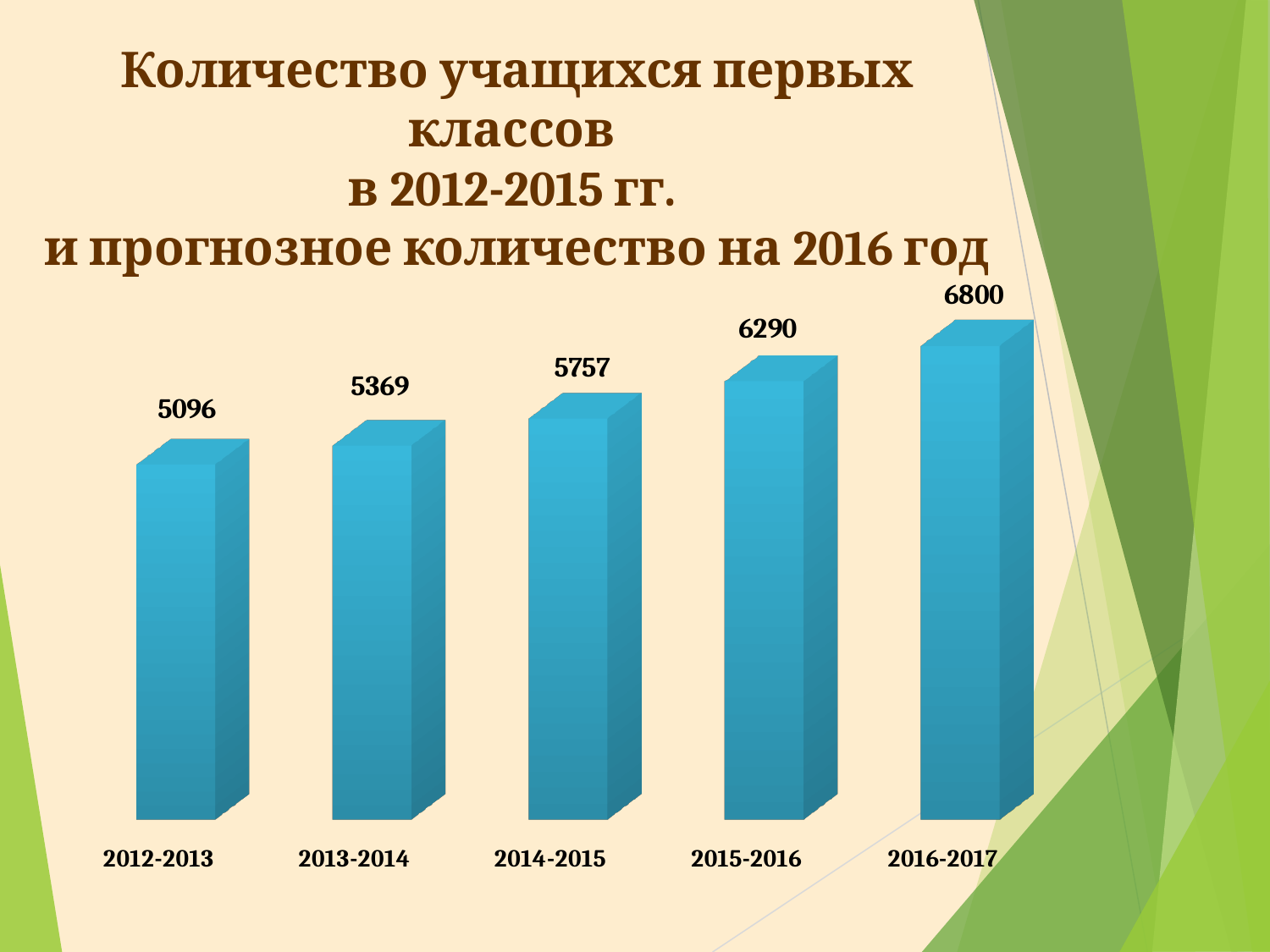
How many categories are shown on the chart? 5 Do the values rise or fall from 2012-2013 to 2016-2017? rise What is the value for 2012-2013? 5096 What is the value for 2016-2017? 6800 What is the difference between the values for 2016-2017 and 2015-2016? 510 What is the difference between the values for 2013-2014 and 2012-2013? 273 Which is larger, the value for 2014-2015 or the value for 2015-2016? 2015-2016 Which category has the lowest value? 2012-2013 Which category has the highest value? 2016-2017 What is the value for 2014-2015? 5757 What kind of chart is shown on the slide? bar chart What colour are the bars on the chart? blue